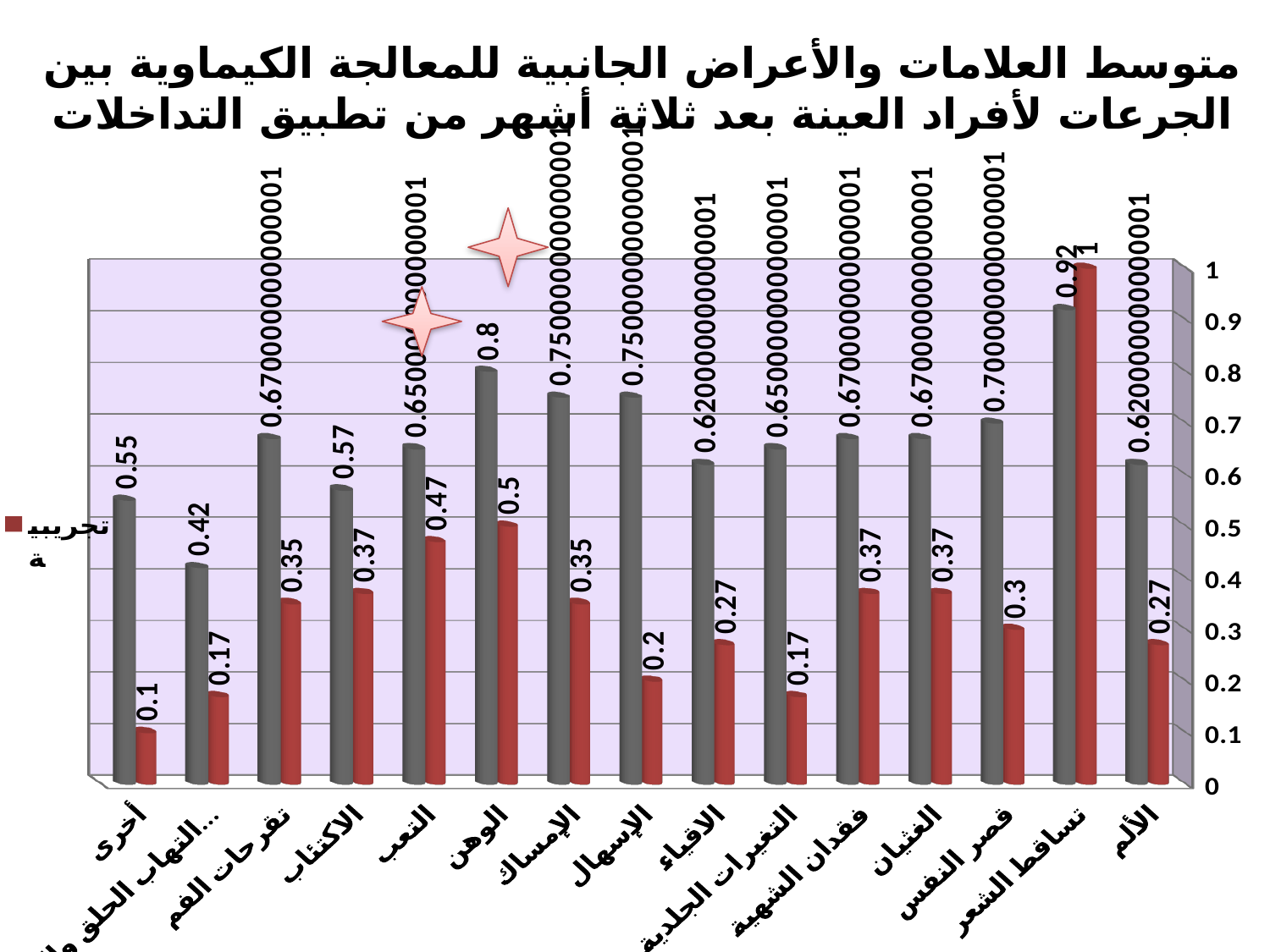
What kind of chart is shown on the slide? bar chart Which is larger: the تجريبية (red) value for الوهن or for الإسهال? الوهن What is the value of the gray bar for الوهن? 0.8 Which category has the highest تجريبية (red) value? تساقط الشعر Which category has the highest gray bar value? تساقط الشعر What is the value of the تجريبية (red) bar for الوهن? 0.5 What is the value of the تجريبية (red) bar for تساقط الشعر? 1 How many categories are shown on the x axis? 15 Which category has the lowest تجريبية (red) value? أخرى What is the value of the gray bar for أخرى? 0.55 What is the difference between the red and gray bars for تساقط الشعر? 0.08 Is the gray bar value for الألم greater or less than 0.5? greater